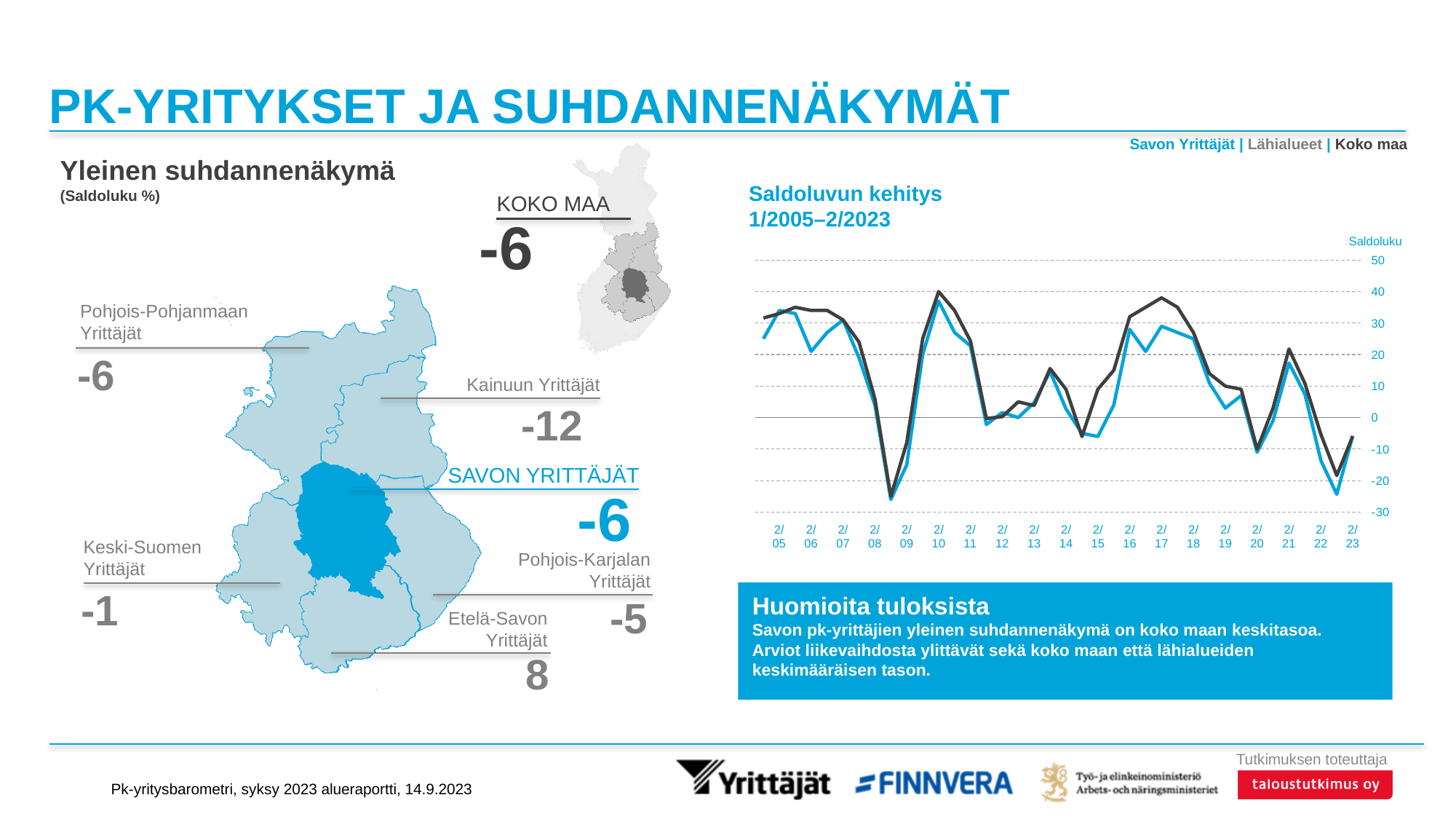
On the 'Saldoluvun kehitys' line chart, how many time points are labelled on the x axis? 19 On the 'Saldoluvun kehitys' line chart, do the values rise or fall between 2/21 and 2/22? fall On the map on the left, what is the value shown for Kainuun Yrittäjät? -12 On the map on the left, which region has the highest value? Etelä-Savon Yrittäjät On the 'Saldoluvun kehitys' line chart, is the value of the dark line at 2/10 greater or less than 30? greater What kind of chart is the 'Saldoluvun kehitys 1/2005–2/2023' chart on the right? line chart On the 'Saldoluvun kehitys' line chart, is the value of the blue line at 2/09 greater or less than -10? less On the map on the left, what is the difference between the value for Etelä-Savon Yrittäjät and the value for Savon Yrittäjät? 14 On the 'Saldoluvun kehitys' line chart, is the value of the blue line at 2/20 greater or less than 0? less On the map on the left, which region has the lowest value? Kainuun Yrittäjät On the 'Saldoluvun kehitys' line chart, what is the highest value shown on the y axis? 50